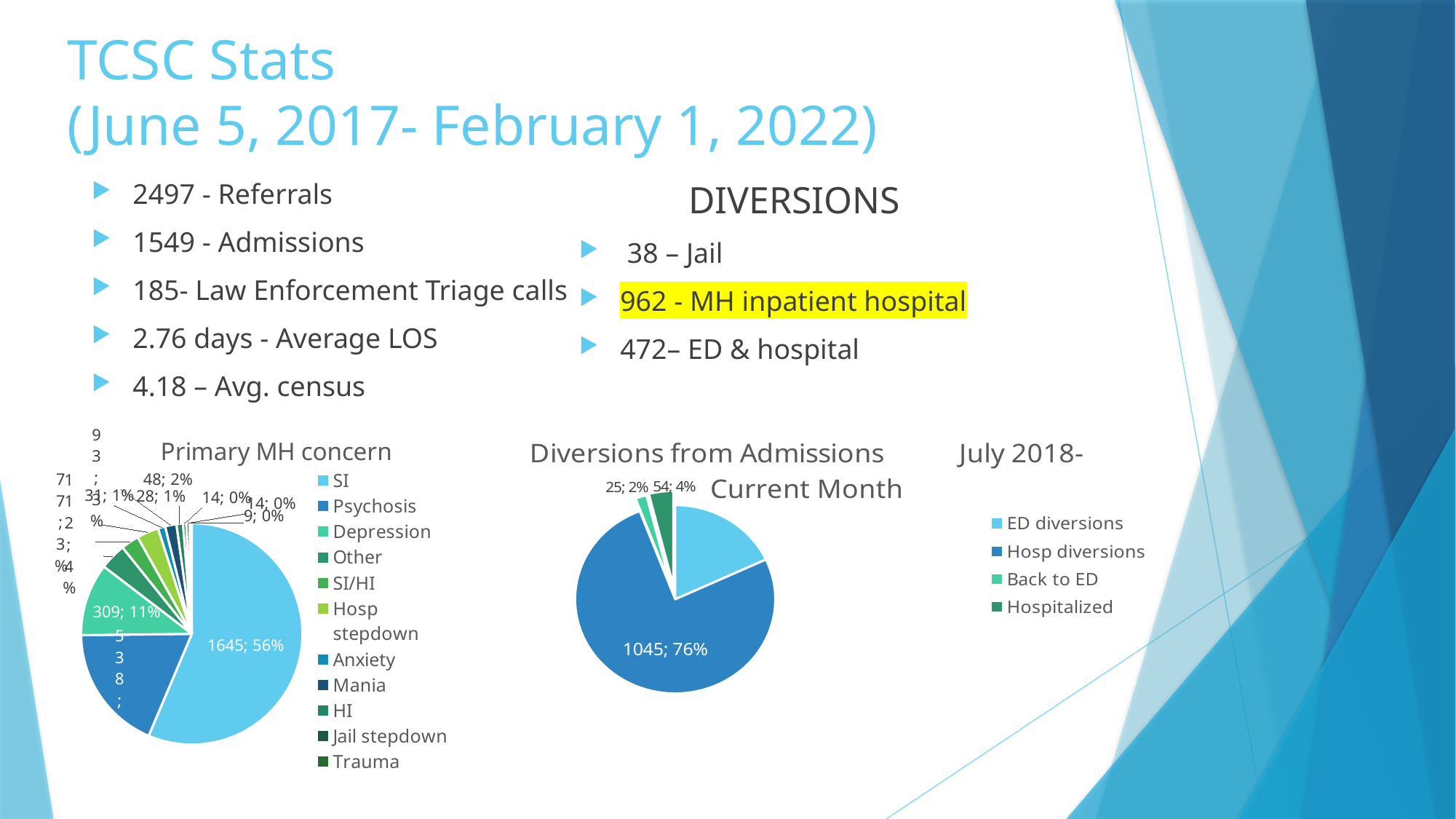
What kind of chart is the 'Primary MH concern' chart? Pie chart In the 'Diversions from Admissions Current Month' chart, which category has the largest slice? Hosp diversions In the 'Primary MH concern' chart, what value and percentage are shown for Depression? 309; 11% In the 'Primary MH concern' chart, what is the difference between the SI count and the Depression count? 1336 How many categories does the legend of the 'Primary MH concern' chart list? 11 In the 'Diversions from Admissions Current Month' chart, what value and percentage are shown for Hosp diversions? 1045; 76% How many categories does the legend of the 'Diversions from Admissions Current Month' chart list? 4 In the 'Primary MH concern' chart, which category has the largest slice? SI In the 'Diversions from Admissions Current Month' chart, which is larger: Hospitalized or Back to ED? Hospitalized In the 'Diversions from Admissions Current Month' chart, what value and percentage are shown for Hospitalized? 54; 4% In the 'Diversions from Admissions Current Month' chart, what value and percentage are shown for Back to ED? 25; 2% In the 'Primary MH concern' chart, what value and percentage are shown for SI? 1645; 56%